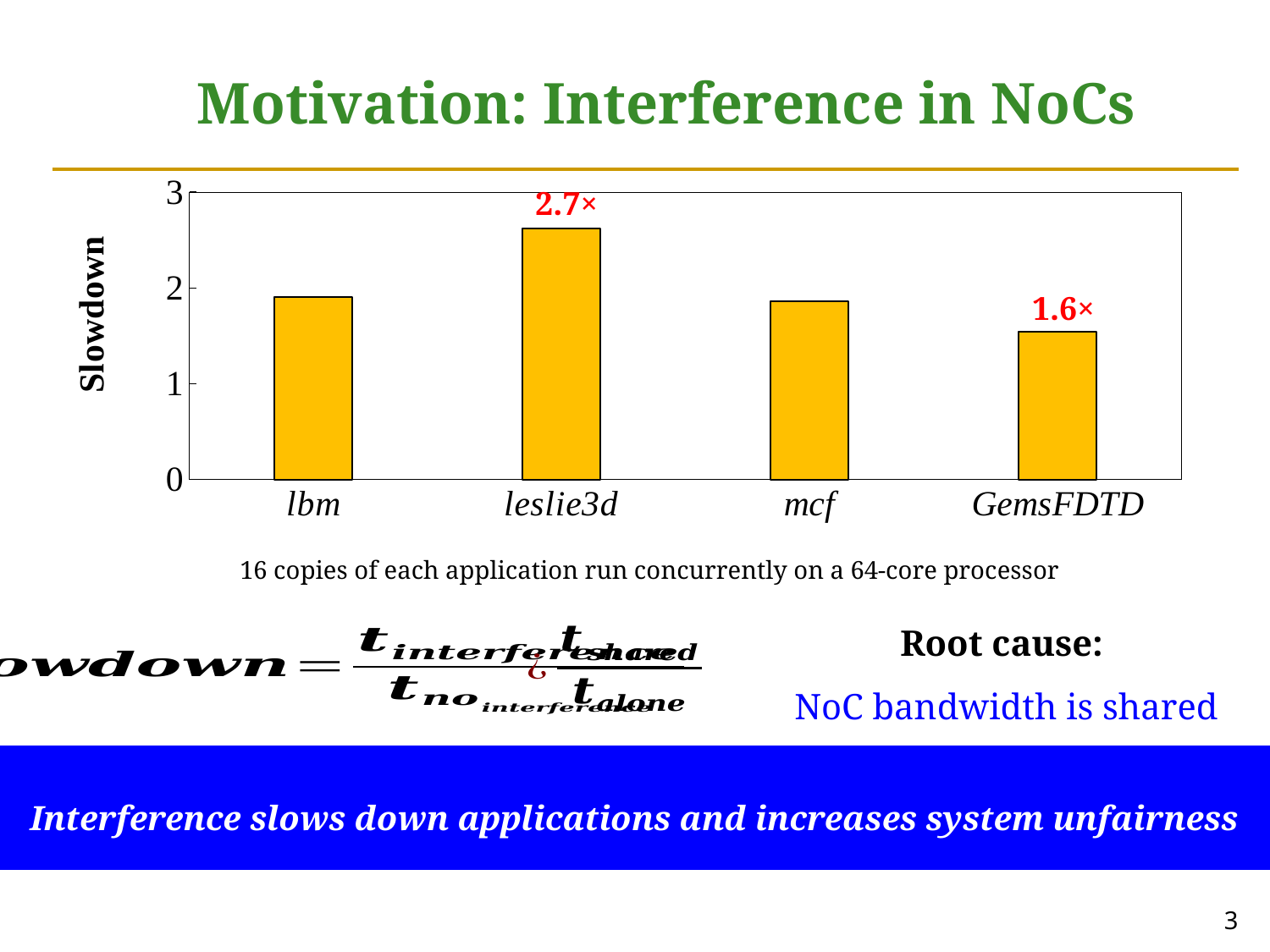
What is the slowdown value labelled for GemsFDTD? 1.6× What is the slowdown value labelled for leslie3d? 2.7× Which application has the highest slowdown? leslie3d Which has a larger slowdown, mcf or GemsFDTD? mcf Is the slowdown value for mcf greater or less than 1? greater Which has a larger slowdown, leslie3d or lbm? leslie3d Is the slowdown value for lbm greater or less than 2? less What is the label on the vertical axis of the chart? Slowdown What is the difference between the labelled slowdown of leslie3d and that of GemsFDTD? 1.1× Which application has the lowest slowdown? GemsFDTD How many applications (categories) are plotted in the chart? 4 What kind of chart is shown on the slide? bar chart